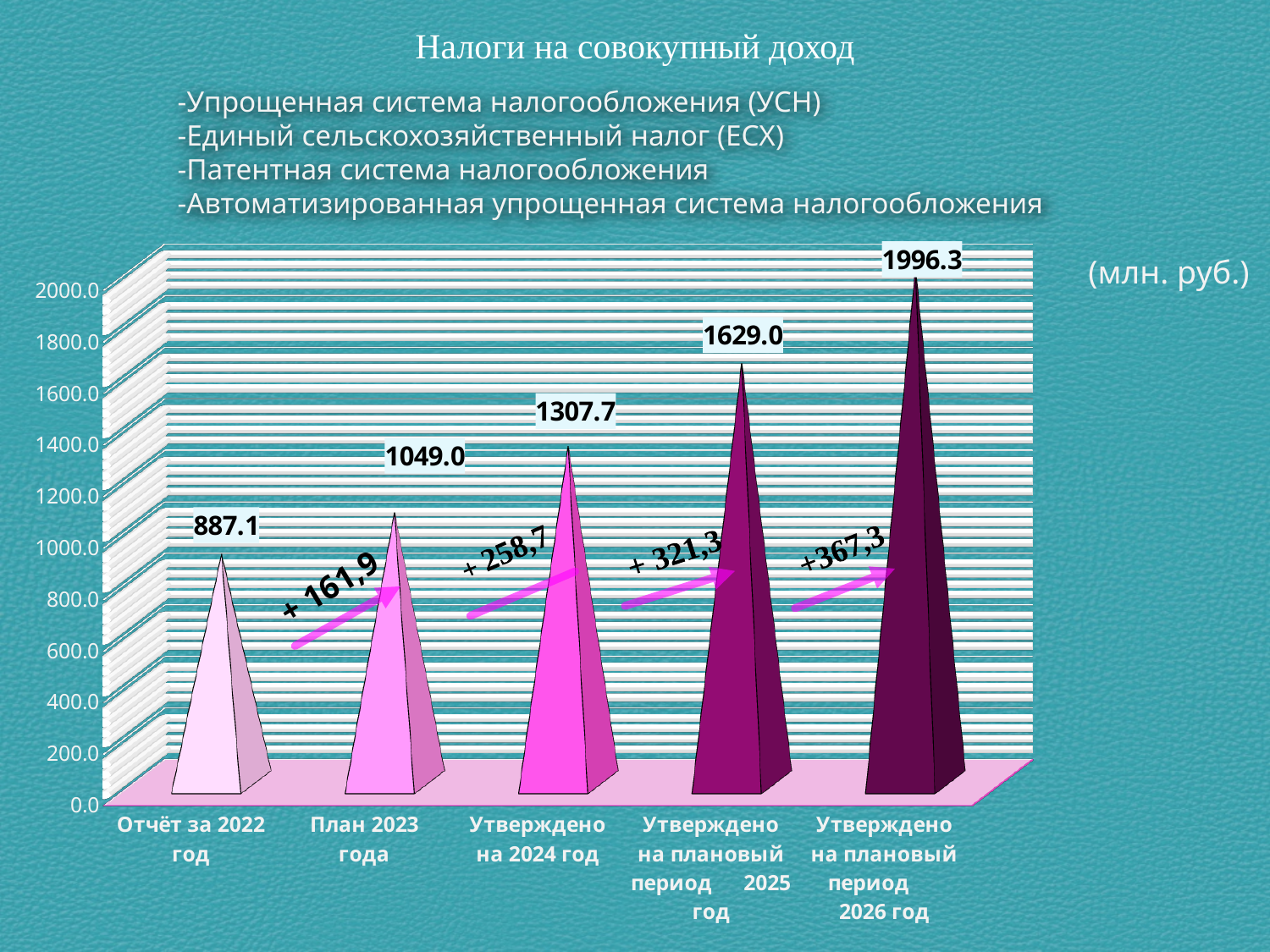
What is the difference between the value for 2026 and the value for 2025? 367.3 Which category has the lowest value? Отчёт за 2022 год How many categories are shown on the x axis? 5 What is the value for «Утверждено на плановый период 2025 год»? 1629.0 Which category has the highest value? Утверждено на плановый период 2026 год What is the value for «Утверждено на 2024 год»? 1307.7 Do the values rise or fall from left to right along the x axis? rise What is the title of the chart? Налоги на совокупный доход What is the value for «План 2023 года»? 1049.0 What is the value for «Утверждено на плановый период 2026 год»? 1996.3 What is the difference between the value for «Утверждено на 2024 год» and «План 2023 года»? 258.7 What is the value for «Отчёт за 2022 год»? 887.1